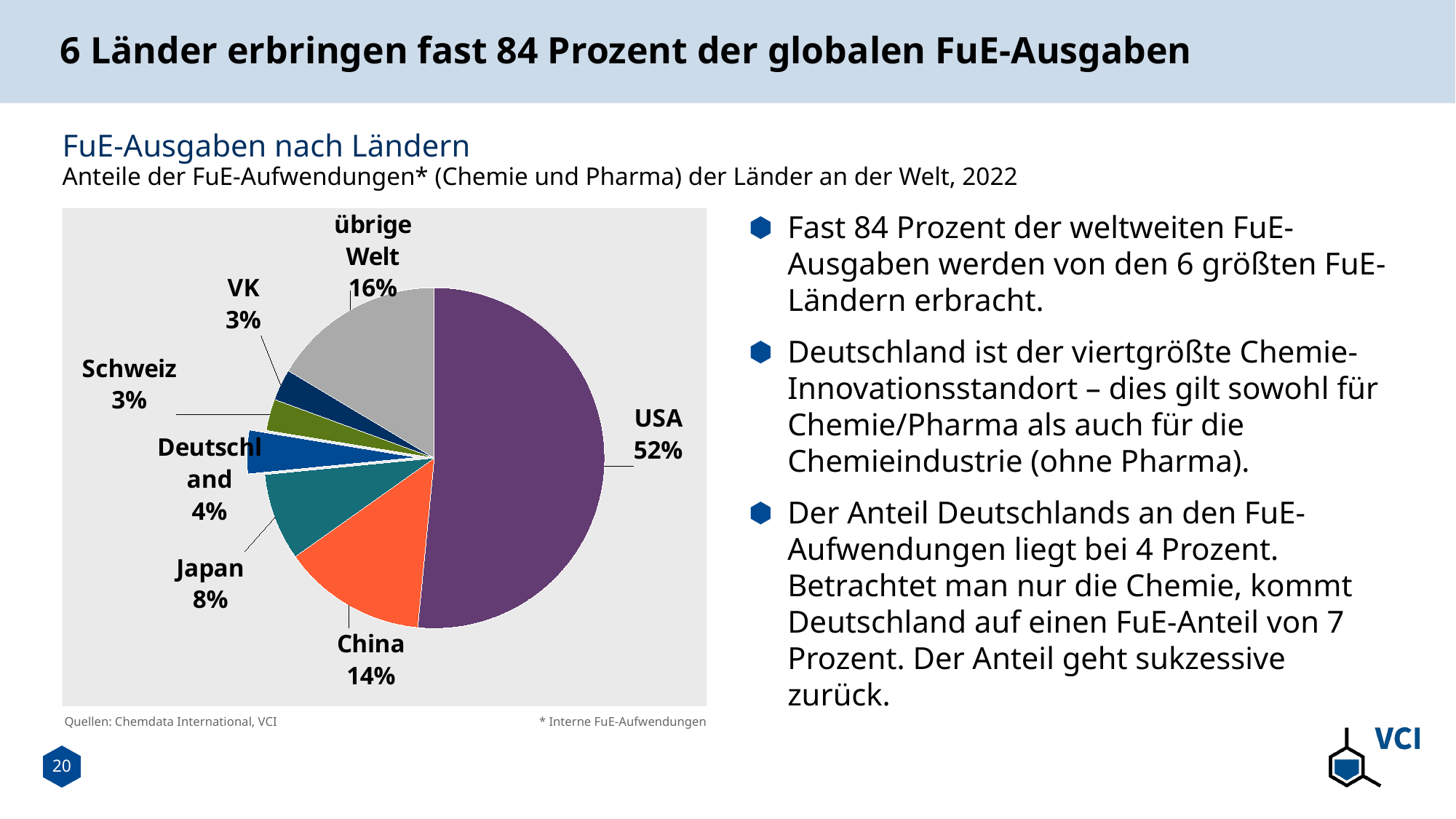
What is the title of the chart? FuE-Ausgaben nach Ländern What is the share shown for Deutschland in the pie chart? 4% What type of chart is shown on the slide? Pie chart What is the combined share of Schweiz and VK in the pie chart? 6% Which has a larger share in the pie chart, China or Japan? China What is the share shown for 'übrige Welt' in the pie chart? 16% How many slices does the pie chart have? 7 What share of global R&D spending does the USA account for in the pie chart? 52% What is the share shown for China in the pie chart? 14% Which country has the largest slice in the pie chart? USA What is the difference in percentage points between the USA's share and China's share? 38 percentage points What is the share shown for Japan in the pie chart? 8%